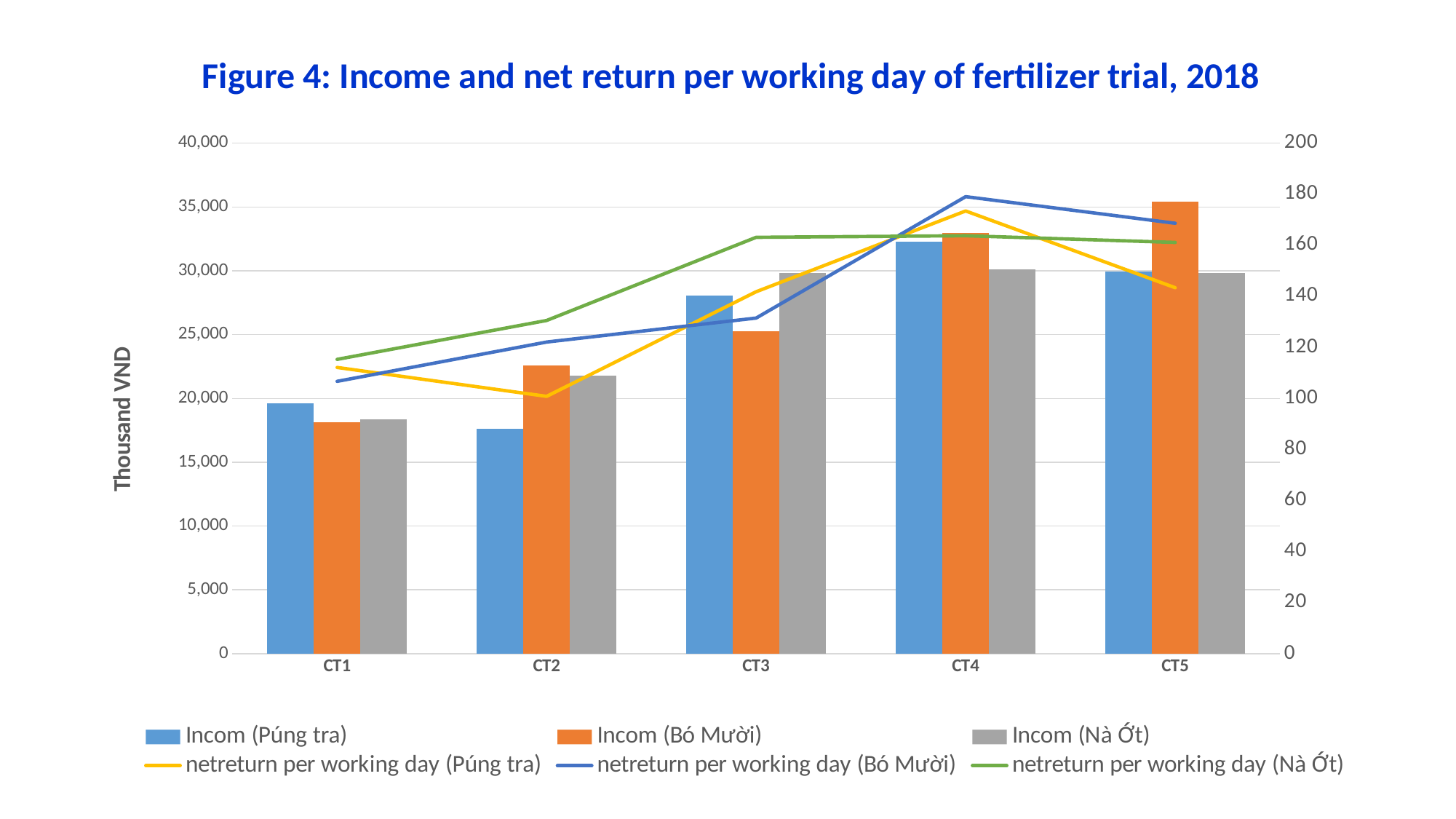
What is the title of the left vertical axis? Thousand VND How many categories are shown on the x axis? 5 At CT2, which is larger: Incom (Bó Mười) or Incom (Púng tra)? Incom (Bó Mười) Does the netreturn per working day (Nà Ớt) line rise or fall from CT1 to CT3? rise How many series does the legend list? 6 For which category is the Incom (Bó Mười) bar the highest? CT5 What kind of chart is shown on the slide? A combination bar and line chart For which category is the Incom (Púng tra) bar the lowest? CT2 At which category does the netreturn per working day (Púng tra) line reach its highest point? CT4 Is the Incom (Púng tra) value for CT1 greater or less than 20,000? less Is the netreturn per working day (Bó Mười) value for CT4 greater or less than 160? greater Is the Incom (Bó Mười) value for CT5 greater or less than 30,000? greater